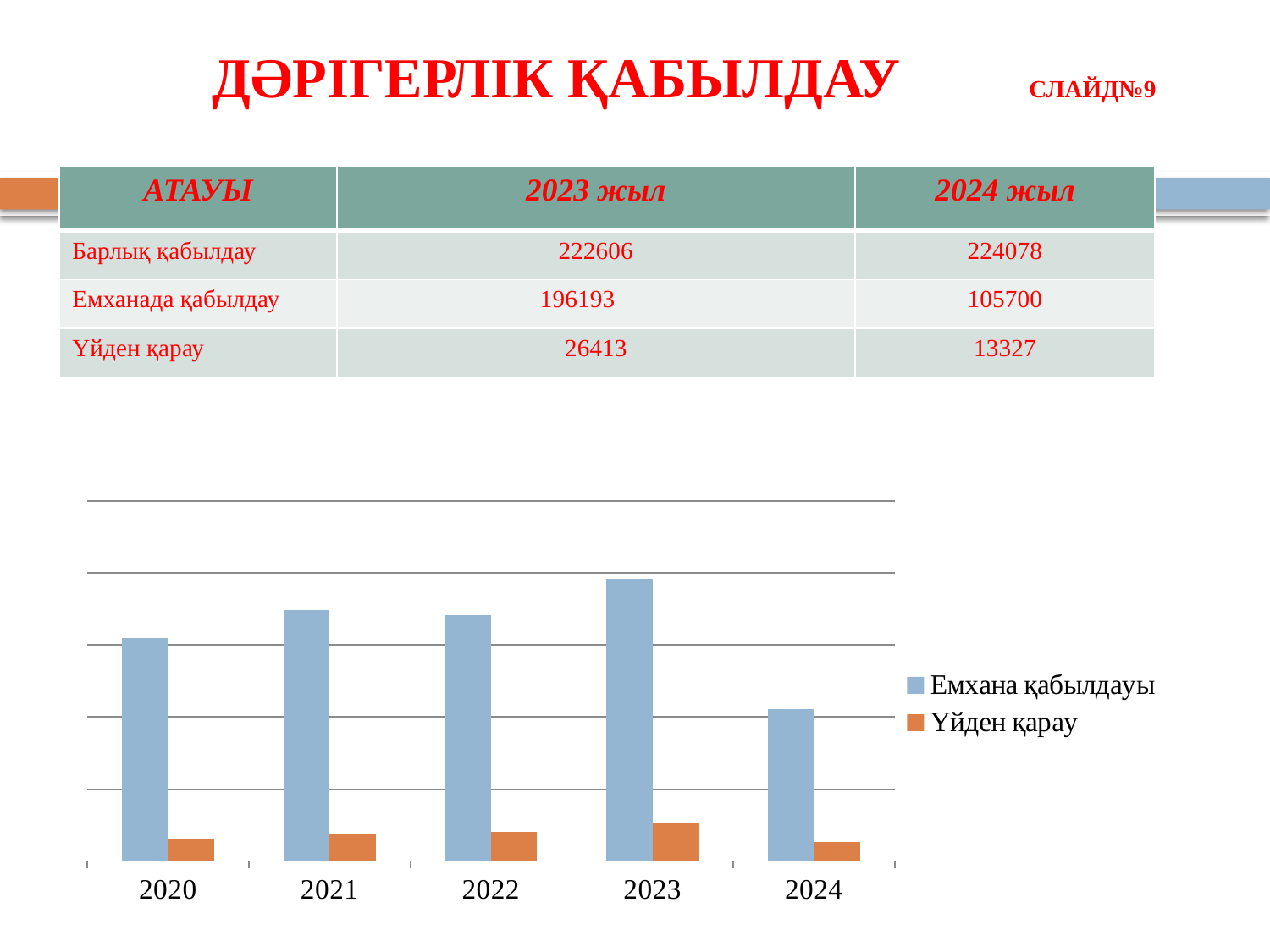
Is the Емхана қабылдауы value larger in 2023 or in 2024? 2023 What kind of chart is shown on the slide? bar chart Which year has the lowest value for Емхана қабылдауы? 2024 Is the Үйден қарау value larger in 2023 or in 2020? 2023 Which series is shown in blue in the chart? Емхана қабылдауы Which year has the highest value for Емхана қабылдауы? 2023 Which series is shown in orange in the chart? Үйден қарау How many series does the chart legend list? 2 Does the Емхана қабылдауы value rise or fall from 2023 to 2024? fall Which year has the highest value for Үйден қарау? 2023 How many years are shown on the x axis of the chart? 5 Is the Емхана қабылдауы value larger in 2020 or in 2021? 2021